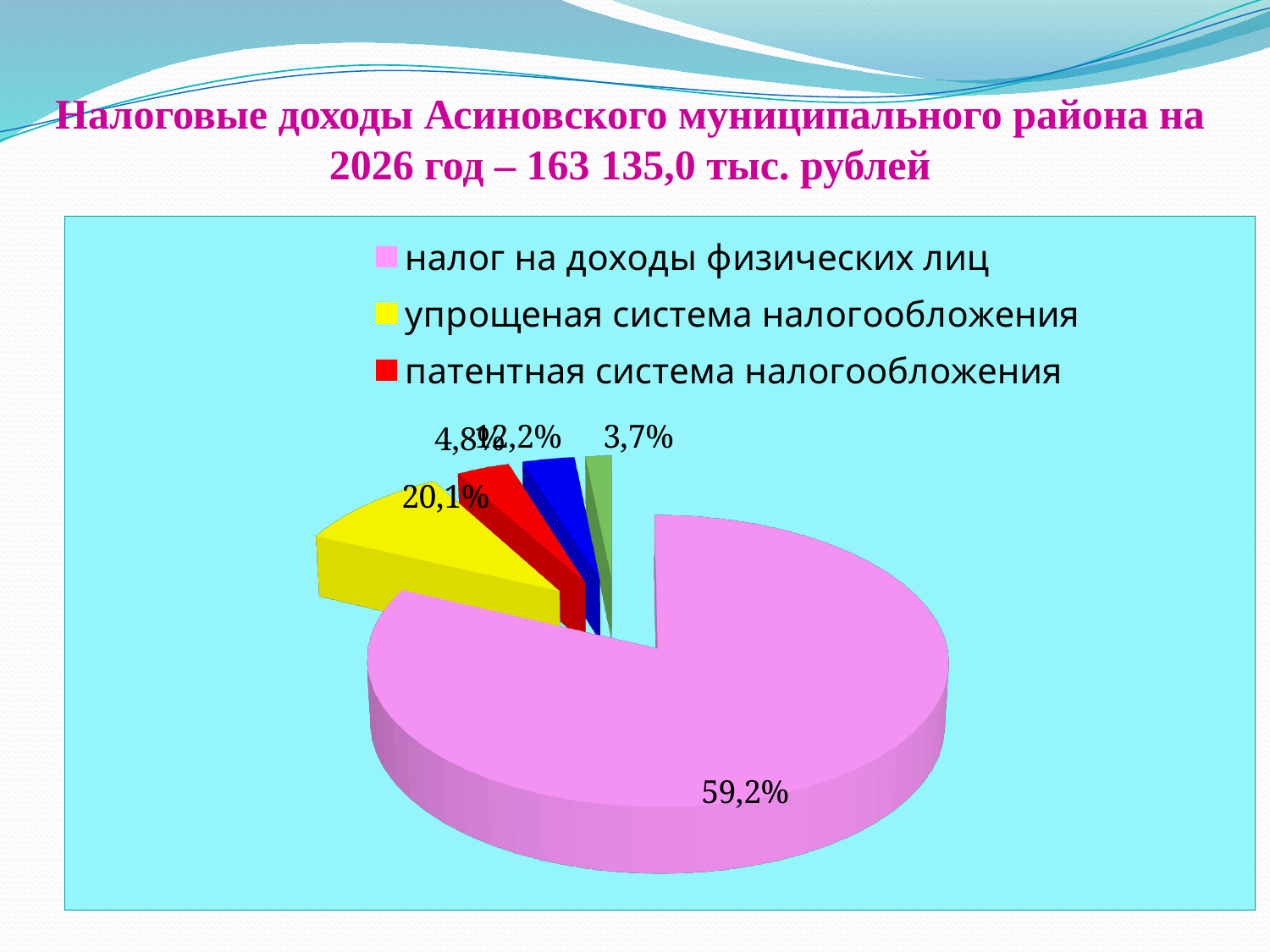
What kind of chart is shown on the slide? pie chart How many slices does the pie chart have? 5 Which is larger: налог на доходы физических лиц or упрощеная система налогообложения? налог на доходы физических лиц What colour is the slice for налог на доходы физических лиц? pink What share of the pie is labelled for налог на доходы физических лиц? 59,2% According to the slide title, what is the total of tax revenues of the Асиновский municipal district for 2026? 163 135,0 тыс. рублей What is the difference between the shares of налог на доходы физических лиц and упрощеная система налогообложения? 39,1% What is the smallest percentage label shown on the pie chart? 3,7% What value is shown for упрощеная система налогообложения? 20,1% Which category has the largest slice of the pie? налог на доходы физических лиц How many entries does the legend list? 3